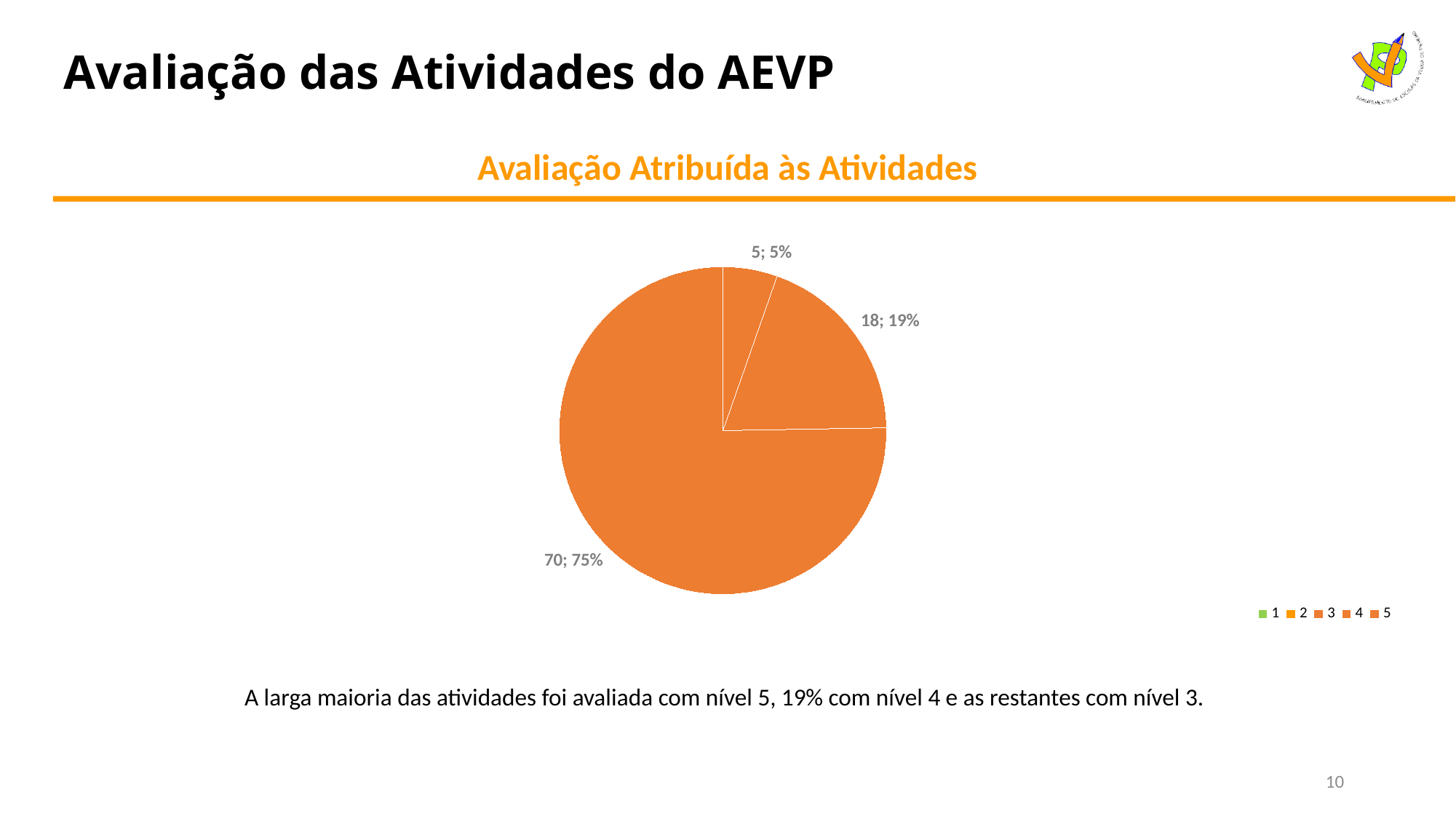
According to the slide, which evaluation level received 19% of the activities? nível 4 What is the difference between the counts of the largest slice (70) and the slice with 18? 52 What is the title of the chart? Avaliação Atribuída às Atividades What kind of chart is shown on the slide? pie chart Which slice is larger: the one labelled 18 or the one labelled 5? 18 What percentage share does the slice with count 18 have? 19% How many slices with data labels are shown in the pie chart? 3 What is the total of the counts shown on the three labelled slices (70, 18 and 5)? 93 How many entries does the chart legend list? 5 What is the count shown for the largest slice of the pie chart? 70 What percentage share does the largest slice of the pie chart have? 75% What is the count shown for the smallest slice of the pie chart? 5